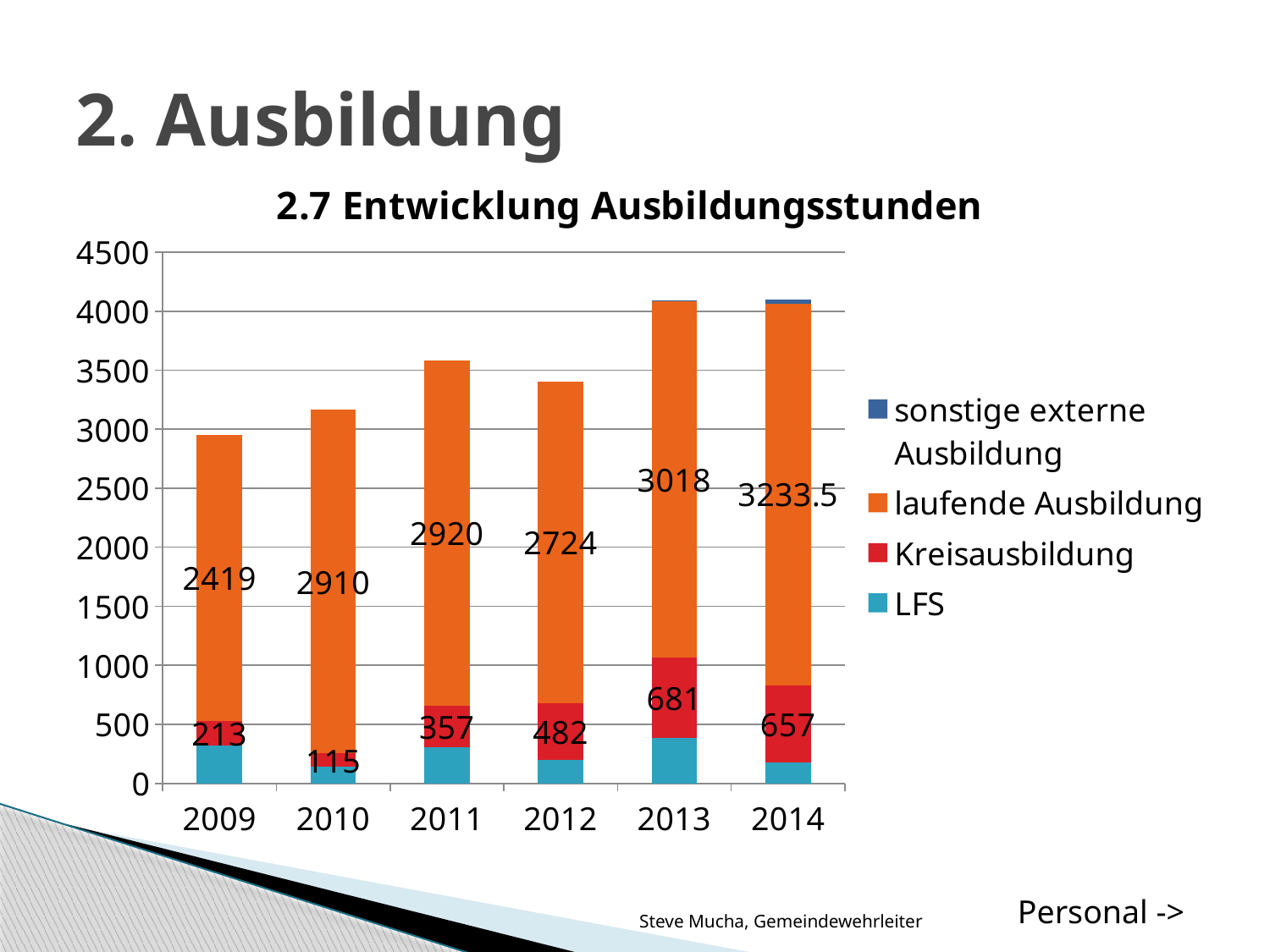
How many years are shown on the x axis? 6 In which year is the laufende Ausbildung value highest? 2014 Is the total height of the 2013 bar greater or less than 4000? greater Do the total bar heights rise or fall from 2009 to 2011? rise What is the value for Kreisausbildung in 2013? 681 How many series does the legend list? 4 In which year is the Kreisausbildung value lowest? 2010 What is the value for laufende Ausbildung in 2010? 2910 What is the difference between the laufende Ausbildung values for 2013 and 2009? 599 What kind of chart is shown on the slide? stacked bar chart What is the value for laufende Ausbildung in 2014? 3233.5 Which year has the larger Kreisausbildung value, 2013 or 2014? 2013